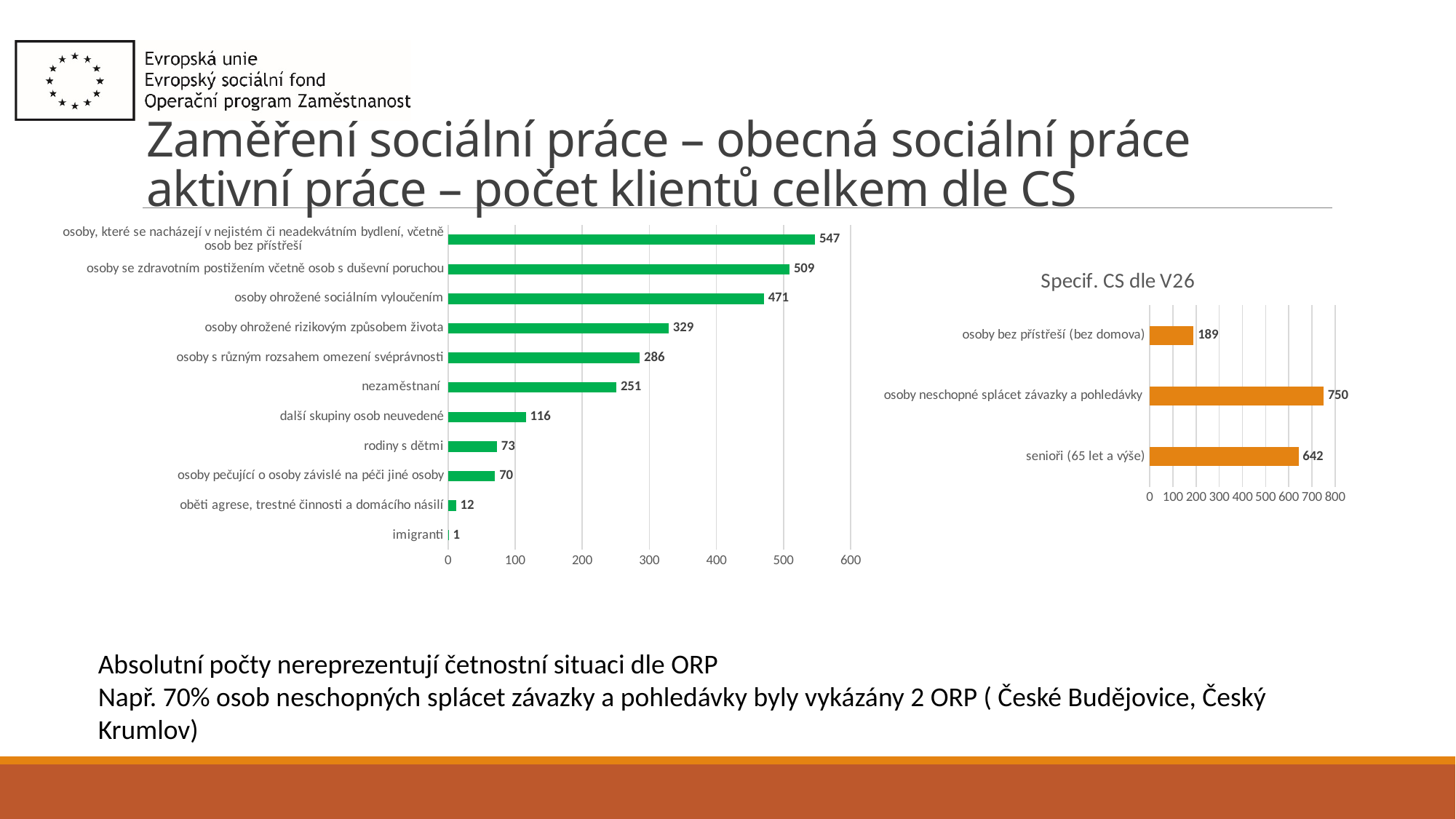
In the left chart, which category has the lowest value? imigranti In the left chart, what is the difference between 'osoby ohrožené rizikovým způsobem života' and 'osoby s různým rozsahem omezení svéprávnosti'? 43 What kind of chart is the chart titled 'Specif. CS dle V26'? bar chart In the chart titled 'Specif. CS dle V26', what is the difference between 'osoby neschopné splácet závazky a pohledávky' and 'osoby bez přístřeší (bez domova)'? 561 In the chart titled 'Specif. CS dle V26', which category has the highest value? osoby neschopné splácet závazky a pohledávky In the chart titled 'Specif. CS dle V26', what is the value for 'senioři (65 let a výše)'? 642 How many categories does the left chart show? 11 In the left chart, which category has the highest value? osoby, které se nacházejí v nejistém či neadekvátním bydlení, včetně osob bez přístřeší In the left chart, which is larger: 'další skupiny osob neuvedené' or 'osoby pečující o osoby závislé na péči jiné osoby'? další skupiny osob neuvedené What colour are the bars in the chart titled 'Specif. CS dle V26'? orange In the left chart, what is the value for 'rodiny s dětmi'? 73 In the left chart, what is the value for 'nezaměstnaní'? 251